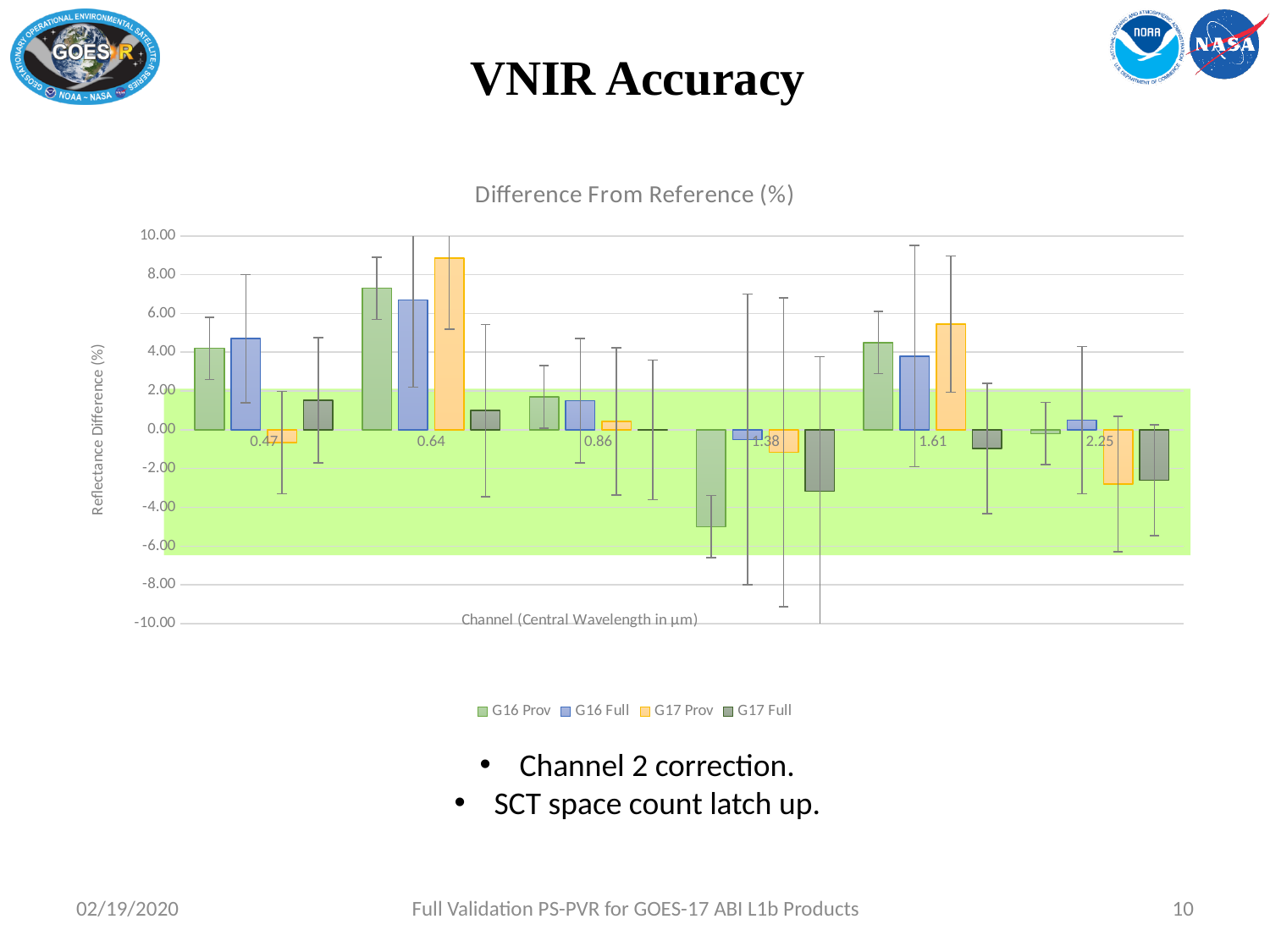
For which channel is the G17 Prov value highest? 0.64 For which channel is the G16 Prov value lowest? 1.38 Is the G17 Full value for channel 1.38 greater or less than -2.00? less Is the G17 Prov value for channel 0.64 greater or less than 8.00? greater What kind of chart is shown on the slide? Bar chart Which series are listed in the chart legend? G16 Prov, G16 Full, G17 Prov, G17 Full Is the G16 Prov value for channel 0.64 greater or less than 6.00? greater What is the title of the chart? Difference From Reference (%) How many channel categories are shown on the x axis? 6 How many series does the chart legend list? 4 For channel 0.64, which is larger: the G17 Prov value or the G16 Full value? G17 Prov